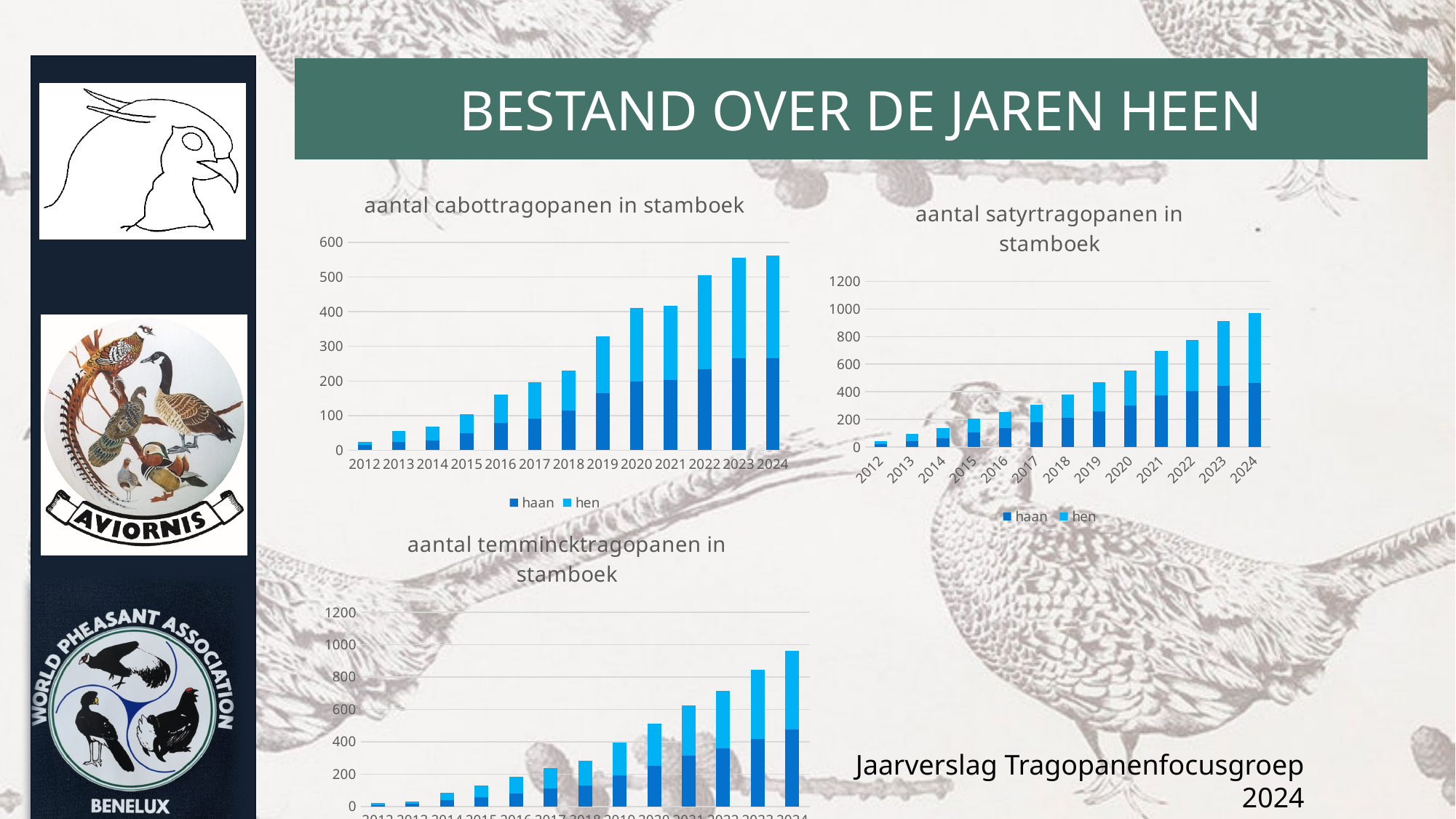
In the chart titled 'aantal temmincktragopanen in stamboek', which year has the highest total? 2024 In the chart titled 'aantal cabottragopanen in stamboek', which year has the lowest total? 2012 In the chart titled 'aantal satyrtragopanen in stamboek', is the total for 2024 greater or less than 1000? less In the chart titled 'aantal cabottragopanen in stamboek', how many years are shown on the x axis? 13 In the chart titled 'aantal cabottragopanen in stamboek', is the total for 2019 greater or less than 300? greater In the chart titled 'aantal satyrtragopanen in stamboek', is the total for 2021 greater or less than 600? greater What kind of chart is the chart titled 'aantal cabottragopanen in stamboek'? stacked bar chart In the chart titled 'aantal satyrtragopanen in stamboek', how many series does the legend list? 2 In the chart titled 'aantal temmincktragopanen in stamboek', do the totals generally rise or fall from 2012 to 2024? rise In the chart titled 'aantal satyrtragopanen in stamboek', which year has the highest total? 2024